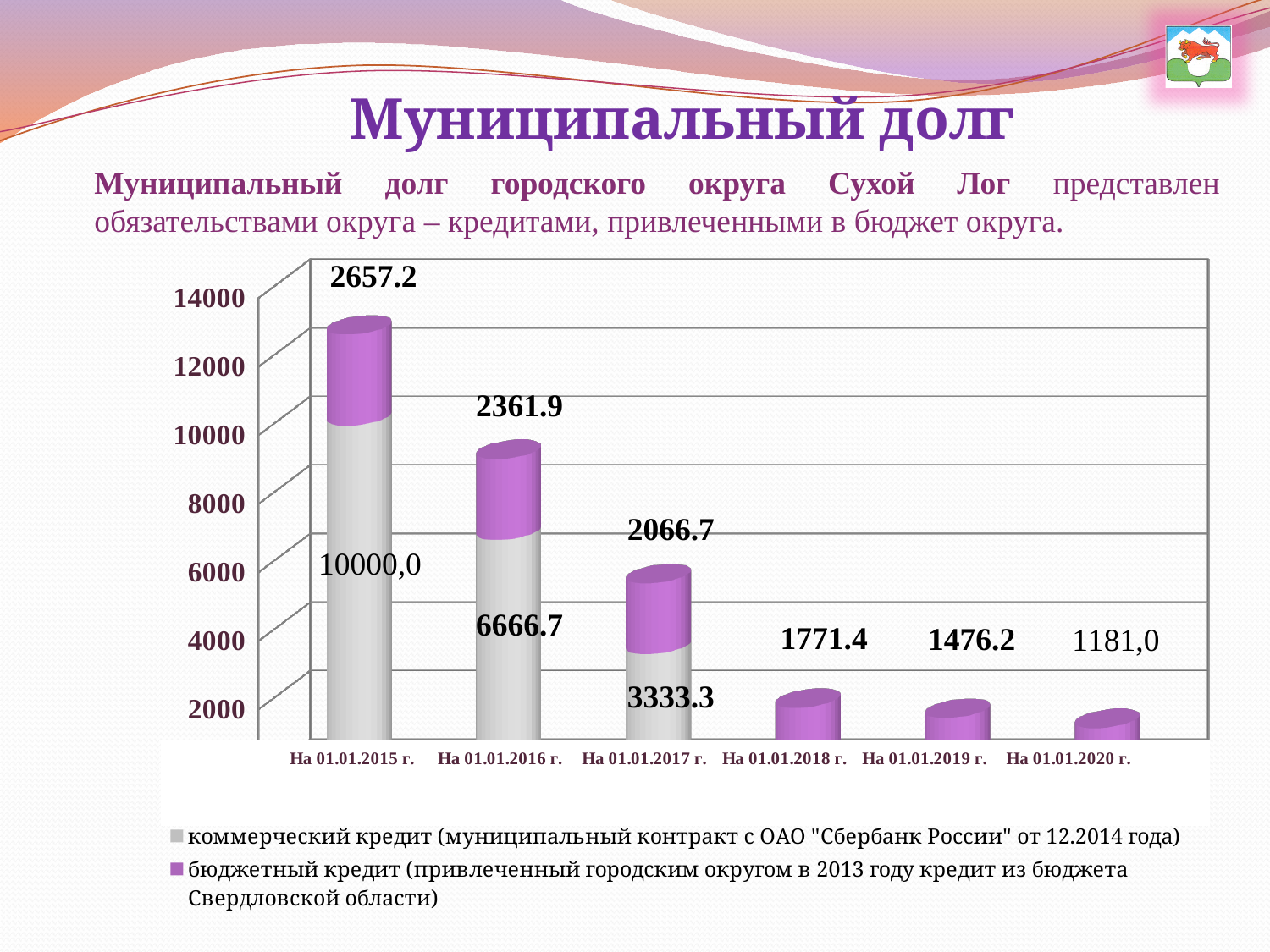
How many series does the legend list? 2 On which date is the бюджетный кредит value the lowest? На 01.01.2020 г. Do the bar heights rise or fall from На 01.01.2015 г. to На 01.01.2020 г.? fall What is the value of the бюджетный кредит series for На 01.01.2015 г.? 2657.2 What type of chart is shown on the slide? bar chart What is the total of the stacked bar for На 01.01.2016 г.? 9028.6 What is the difference between the бюджетный кредит values for На 01.01.2015 г. and На 01.01.2016 г.? 295.3 Which is larger: the коммерческий кредит value for На 01.01.2016 г. or for На 01.01.2017 г.? На 01.01.2016 г. How many dates (categories) are shown on the x axis? 6 What is the value of the коммерческий кредит series for На 01.01.2017 г.? 3333.3 What is the value of the бюджетный кредит series for На 01.01.2019 г.? 1476.2 What is the value of the коммерческий кредит series for На 01.01.2016 г.? 6666.7